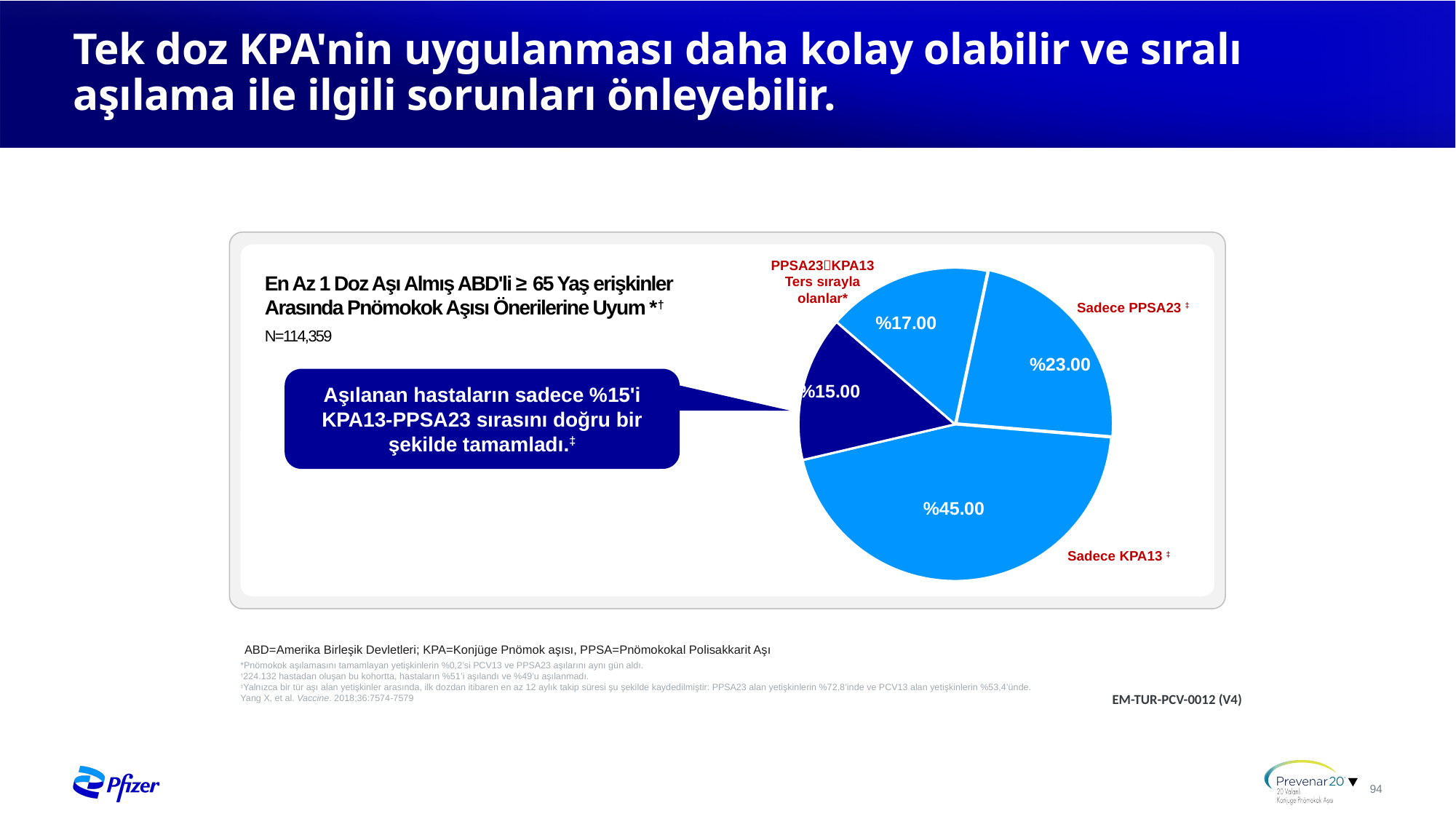
What percentage does the callout box say completed the KPA13-PPSA23 sequence correctly? %15 What is the value of the 'Sadece PPSA23' slice? %23.00 What is the value shown on the dark blue slice of the pie? %15.00 Which slice of the pie is the smallest? the dark blue slice (%15.00) What is the difference between the 'Sadece KPA13' slice and the 'Sadece PPSA23' slice? 22 percentage points What is the sample size (N) stated for the chart? N=114,359 Which slice of the pie is the largest? Sadece KPA13 Which is larger, the 'Sadece PPSA23' slice or the 'PPSA23→KPA13 Ters sırayla olanlar' slice? Sadece PPSA23 What kind of chart is shown on the slide? pie chart What is the value of the 'Sadece KPA13' slice? %45.00 What is the value of the 'PPSA23→KPA13 Ters sırayla olanlar' slice? %17.00 How many slices does the pie chart have? 4